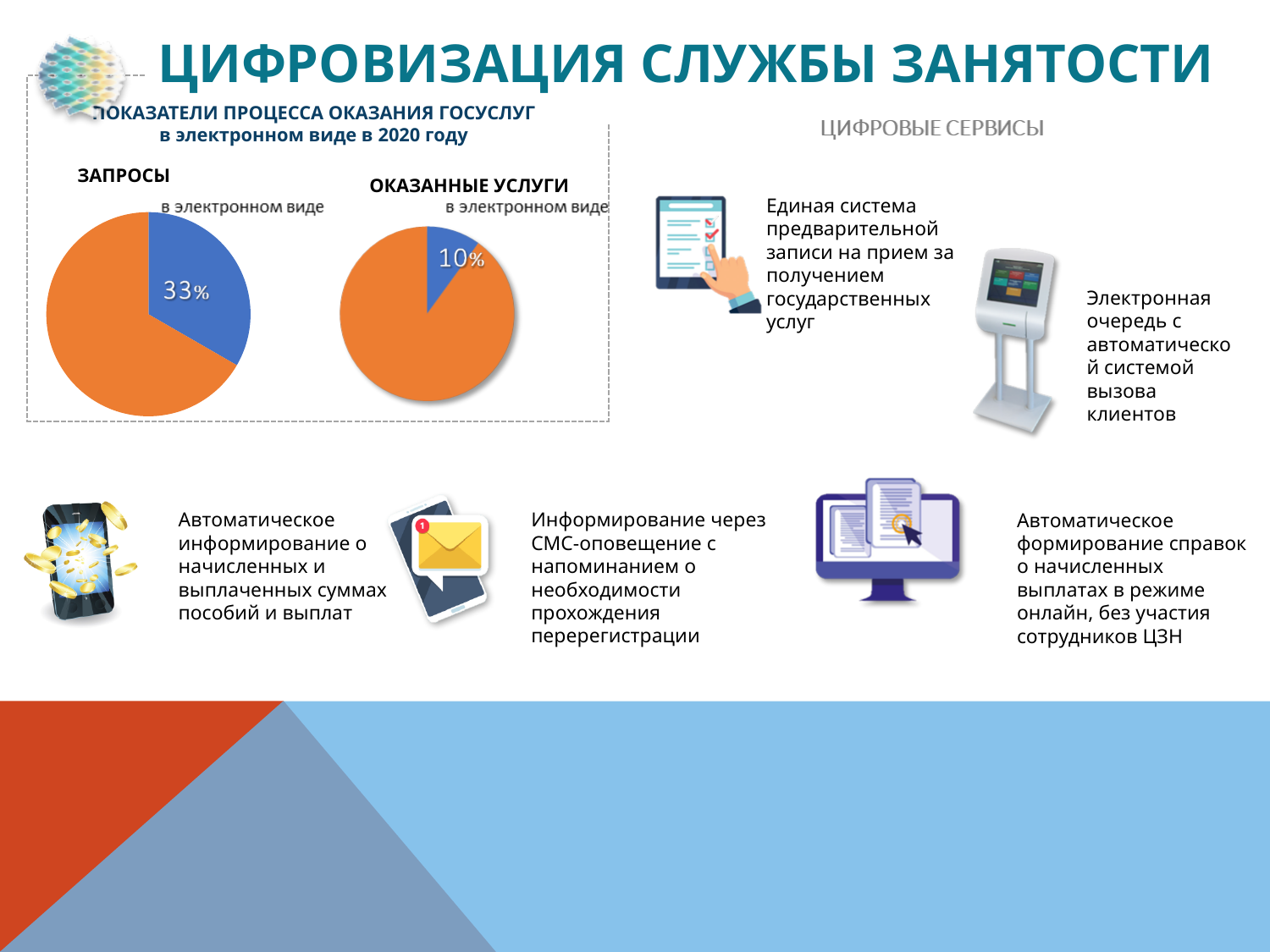
In the "ОКАЗАННЫЕ УСЛУГИ" pie chart, which slice is the largest, the blue one or the orange one? The orange one Which pie chart shows the larger electronic ("в электронном виде") share, "ЗАПРОСЫ" or "ОКАЗАННЫЕ УСЛУГИ"? ЗАПРОСЫ For which year do the pie charts show the indicators, according to the heading above them? 2020 What type of chart is the "ЗАПРОСЫ" chart? Pie chart How many slices does the "ОКАЗАННЫЕ УСЛУГИ" pie chart have? 2 What colour is the slice labelled "в электронном виде" in both pie charts? Blue By how many percentage points does the electronic share in "ЗАПРОСЫ" exceed the electronic share in "ОКАЗАННЫЕ УСЛУГИ"? 23 percentage points In the "ОКАЗАННЫЕ УСЛУГИ" pie chart, what share is labelled "в электронном виде"? 10% How many pie charts are shown on the slide? 2 In the "ЗАПРОСЫ" pie chart, what share is labelled "в электронном виде"? 33% In the "ЗАПРОСЫ" pie chart, is the blue slice larger or smaller than the orange slice? Smaller